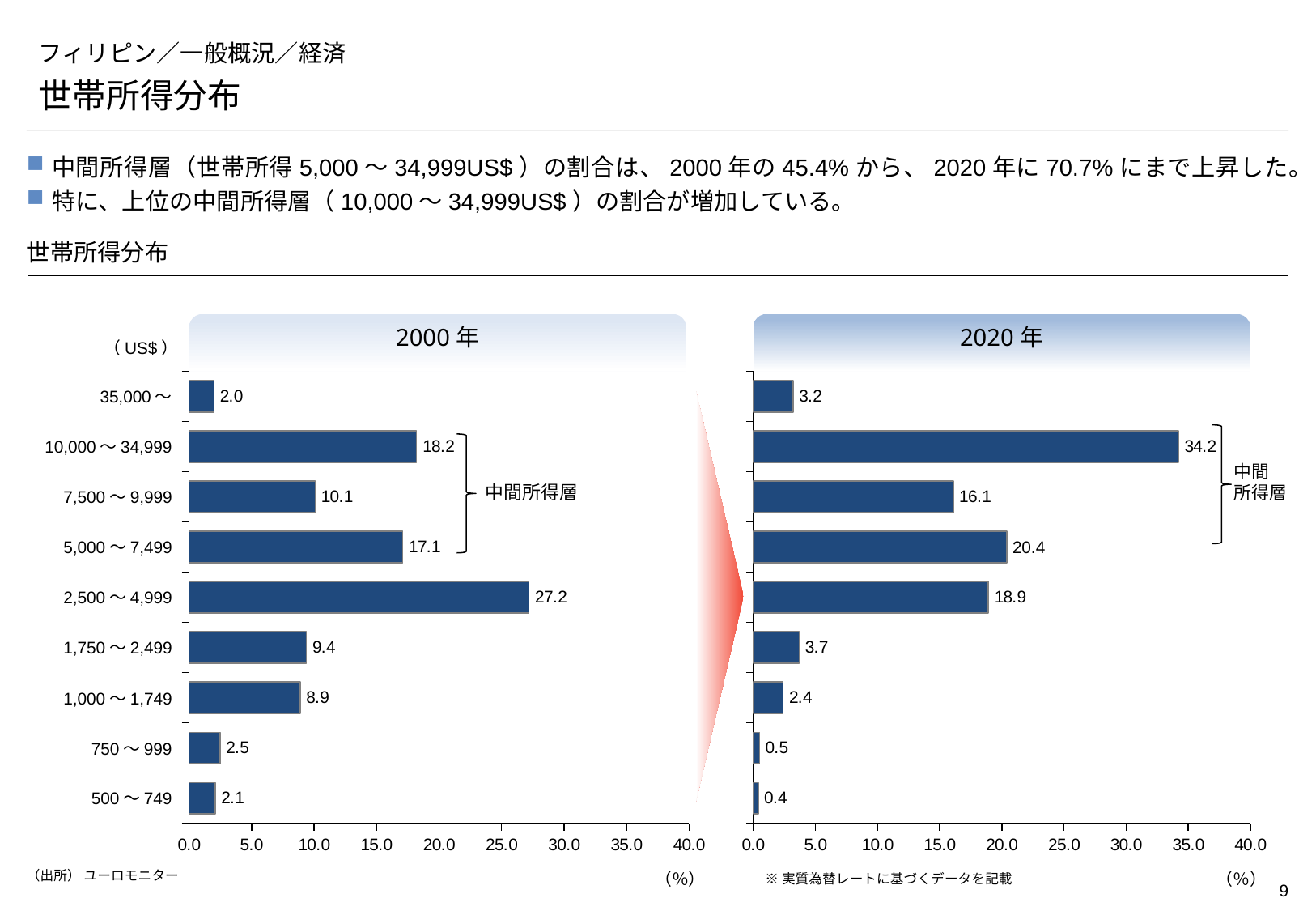
In the 2000年 chart, what is the total of the three bands bracketed as 中間所得層 (5,000～7,499, 7,500～9,999, 10,000～34,999)? 45.4 How many income bands are shown in the 2000年 chart? 9 What kind of chart is the 2020年 chart? Bar chart In the 2020年 chart, what is the difference between the values for 10,000～34,999 and 5,000～7,499? 13.8 In the 2000年 chart, which is larger: the value for 5,000～7,499 or the value for 7,500～9,999? 5,000～7,499 In the 2020年 chart, which income band has the lowest value? 500～749 In the 2020年 chart, what is the value for the 10,000～34,999 income band? 34.2 In the 2000年 chart, which income band has the highest value? 2,500～4,999 In the 2020年 chart, is the value for 7,500～9,999 greater or less than 15.0? greater What is the unit shown on the x axis of both charts? % In the 2020年 chart, what is the value for the 35,000～ income band? 3.2 In the 2000年 chart, what is the value for the 2,500～4,999 income band? 27.2